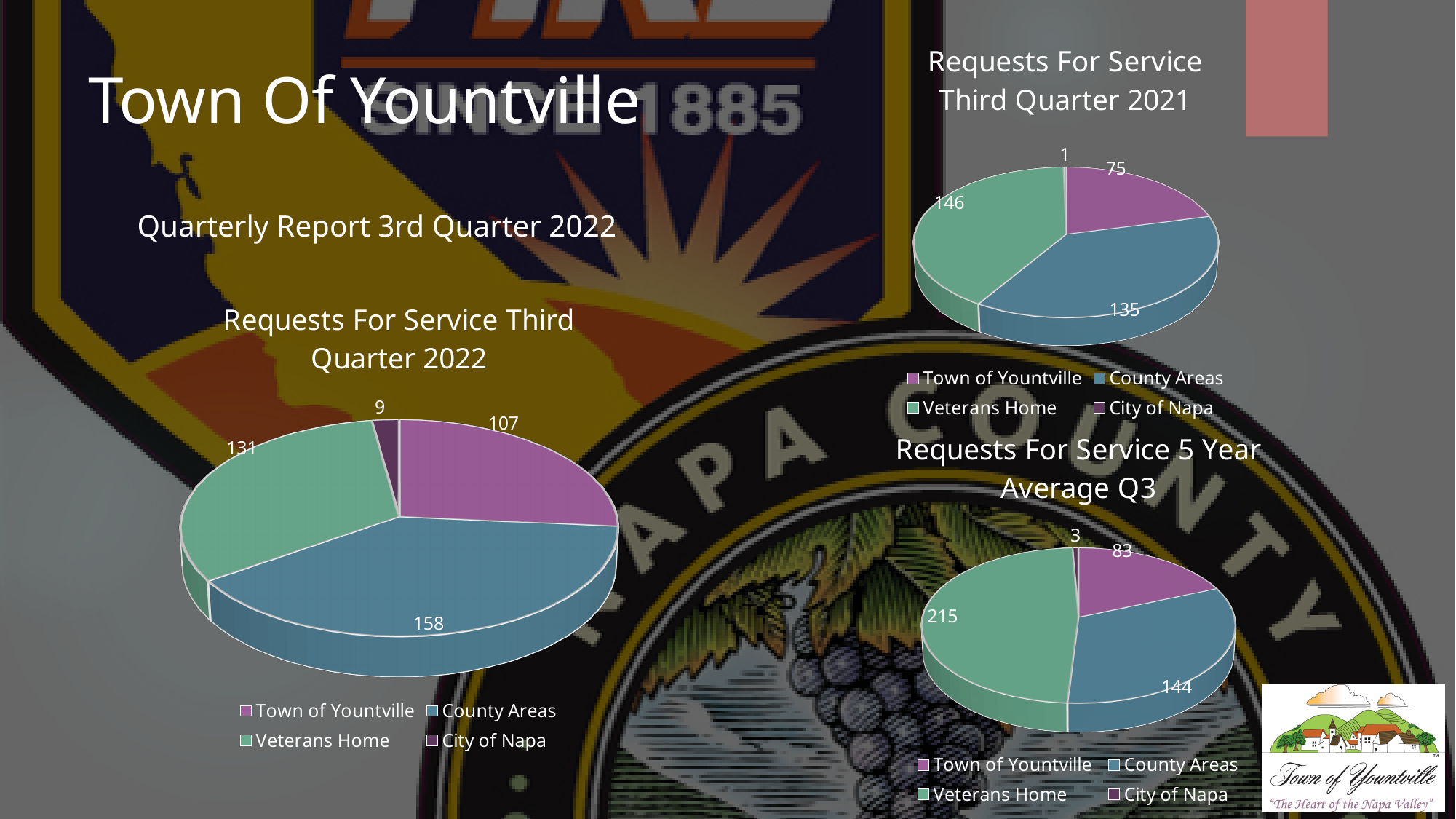
What kind of chart is 'Requests For Service Third Quarter 2022'? Pie chart In the 'Requests For Service 5 Year Average Q3' chart, what is the difference between Veterans Home and County Areas? 71 In the 'Requests For Service 5 Year Average Q3' chart, which category has the largest value? Veterans Home How many categories does the 'Requests For Service 5 Year Average Q3' chart show? 4 In the 'Requests For Service Third Quarter 2022' chart, what is the difference between County Areas and Veterans Home? 27 In the 'Requests For Service Third Quarter 2021' chart, which is larger, Town of Yountville or County Areas? County Areas In the 'Requests For Service Third Quarter 2022' chart, what is the value for City of Napa? 9 In the 'Requests For Service Third Quarter 2021' chart, which category has the smallest value? City of Napa In the 'Requests For Service 5 Year Average Q3' chart, what is the value for Town of Yountville? 83 In the 'Requests For Service Third Quarter 2022' chart, what is the value for County Areas? 158 In the 'Requests For Service Third Quarter 2022' chart, what is the total of all slices? 405 In the 'Requests For Service Third Quarter 2021' chart, what is the value for Veterans Home? 146